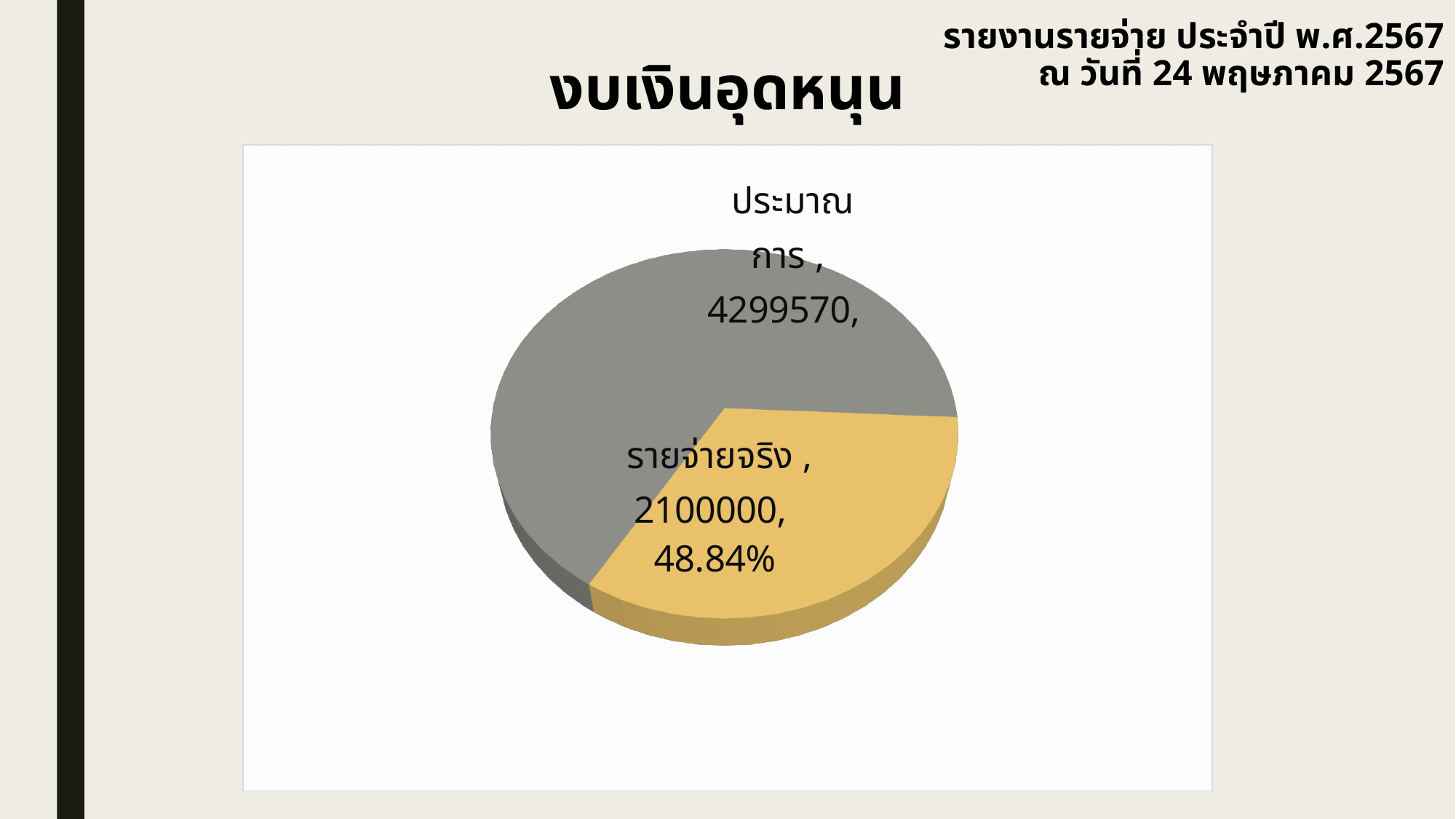
What is the value shown for รายจ่ายจริง in the pie chart? 2100000 Which is larger, ประมาณการ or รายจ่ายจริง? ประมาณการ Which slice of the pie chart is the smallest? รายจ่ายจริง What percentage is printed on the รายจ่ายจริง slice? 48.84% What is the title of the chart on the slide? งบเงินอุดหนุน What is the difference between the ประมาณการ value and the รายจ่ายจริง value? 2199570 What is the value shown for ประมาณการ in the pie chart? 4299570 Which slice of the pie chart is the largest? ประมาณการ How many slices does the pie chart have? 2 What colour is the รายจ่ายจริง slice? yellow What kind of chart is shown on the slide? pie chart